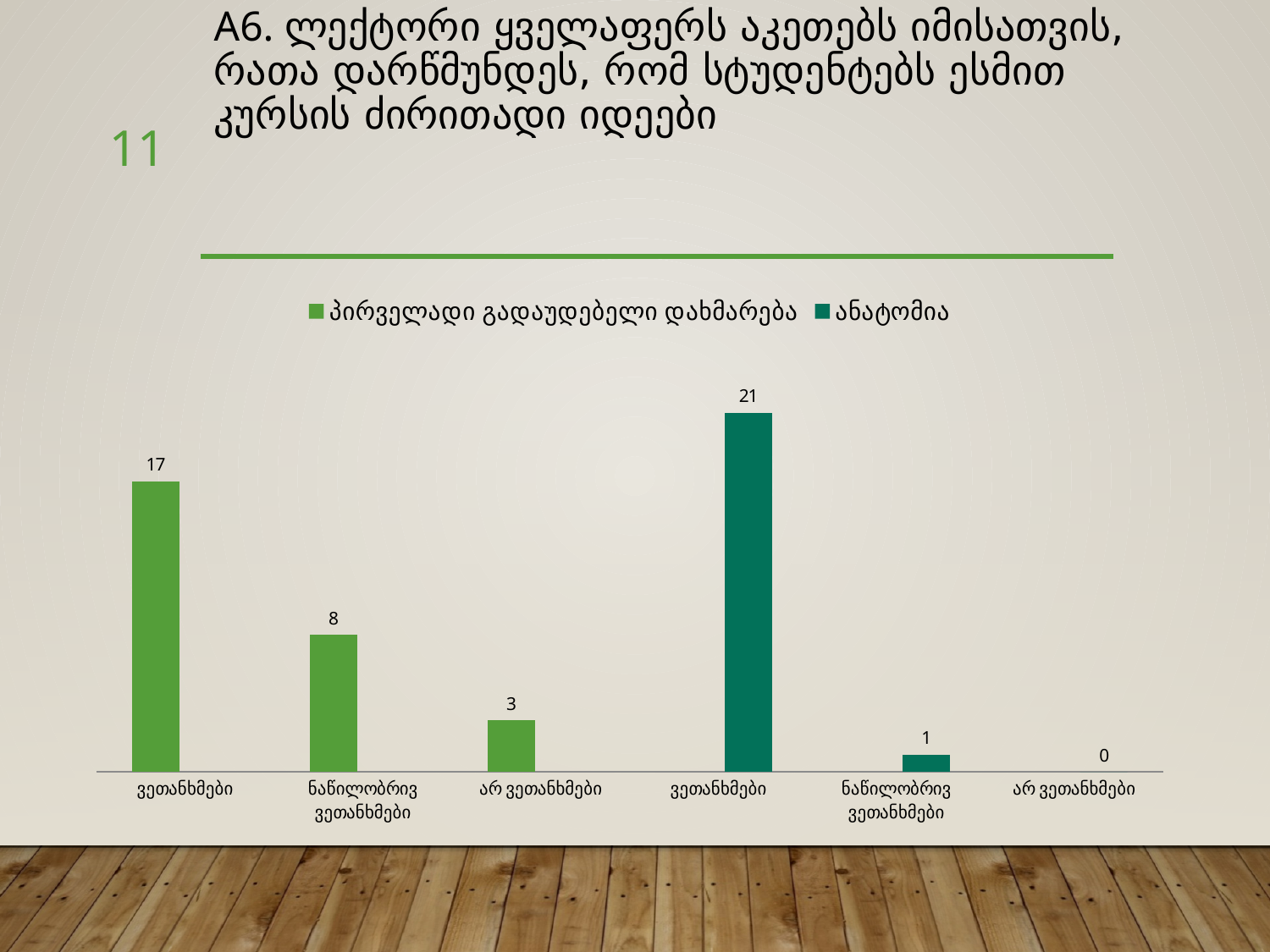
What is the value for ვეთანხმები in the პირველადი გადაუდებელი დახმარება series? 17 How many series does the legend list? 2 What is the value for არ ვეთანხმები in the პირველადი გადაუდებელი დახმარება series? 3 What kind of chart is shown on the slide? bar chart How many bars are plotted on the chart in total? 5 What is the value for ნაწილობრივ ვეთანხმები in the პირველადი გადაუდებელი დახმარება series? 8 What is the value for ნაწილობრივ ვეთანხმები in the ანატომია series? 1 Which is larger: ნაწილობრივ ვეთანხმები in the პირველადი გადაუდებელი დახმარება series or ნაწილობრივ ვეთანხმები in the ანატომია series? პირველადი გადაუდებელი დახმარება What is the difference between ვეთანხმები in the ანატომია series and ვეთანხმები in the პირველადი გადაუდებელი დახმარება series? 4 What is the value for ვეთანხმები in the ანატომია series? 21 Which bar has the highest value on the chart? ვეთანხმები (ანატომია) What is the value for არ ვეთანხმები in the ანატომია series? 0